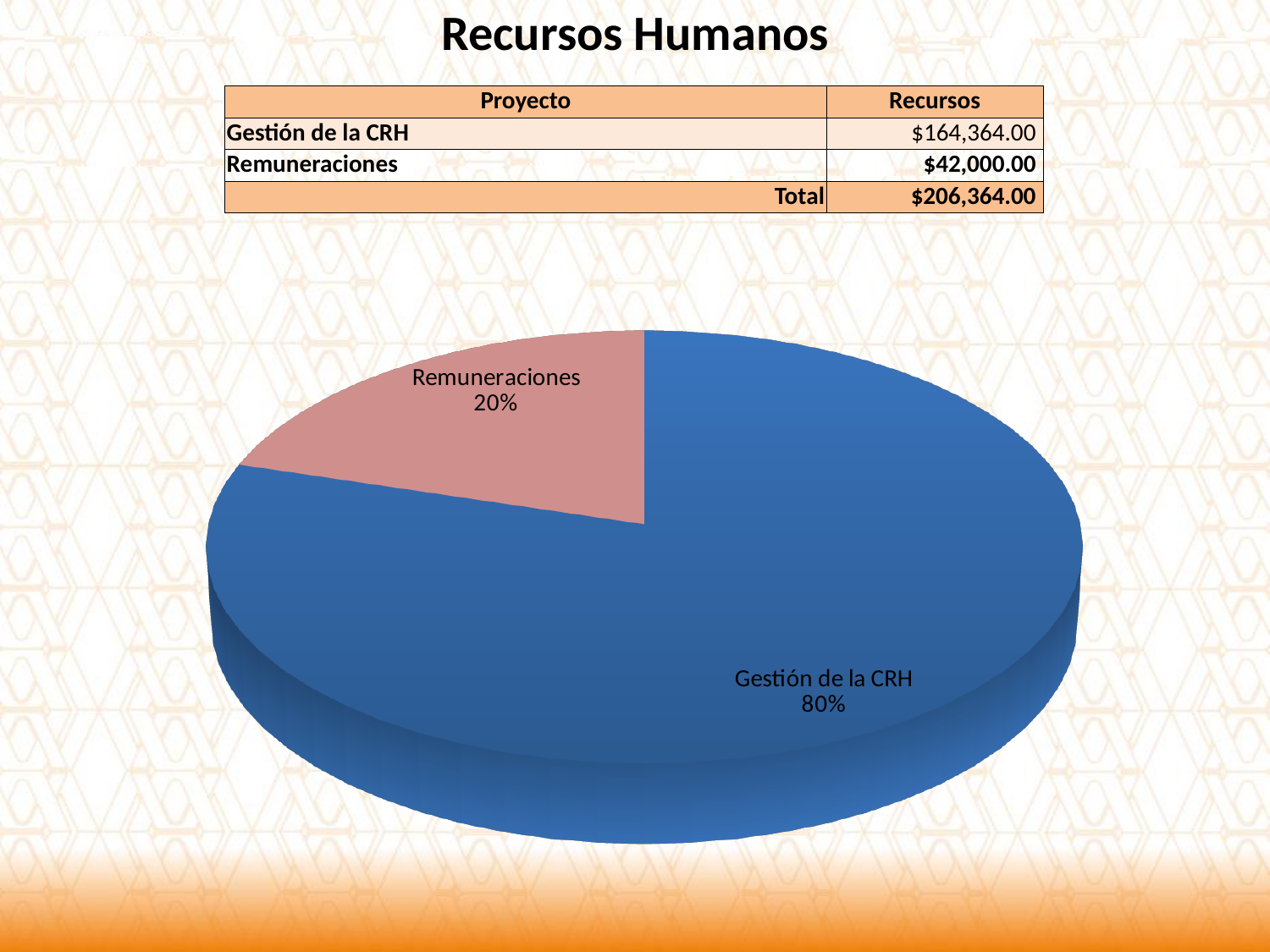
What colour is the Gestión de la CRH slice of the pie? Blue What share of the pie does Gestión de la CRH represent? 80% How many slices does the pie chart have? 2 What kind of chart is shown on the slide? Pie chart Which slice of the pie is the smallest? Remuneraciones What is the difference in percentage points between the Gestión de la CRH slice and the Remuneraciones slice? 60 percentage points Which slice of the pie is the largest? Gestión de la CRH What is the title shown above the chart on the slide? Recursos Humanos Which is larger, the slice for Gestión de la CRH or the slice for Remuneraciones? Gestión de la CRH What share of the pie does Remuneraciones represent? 20%